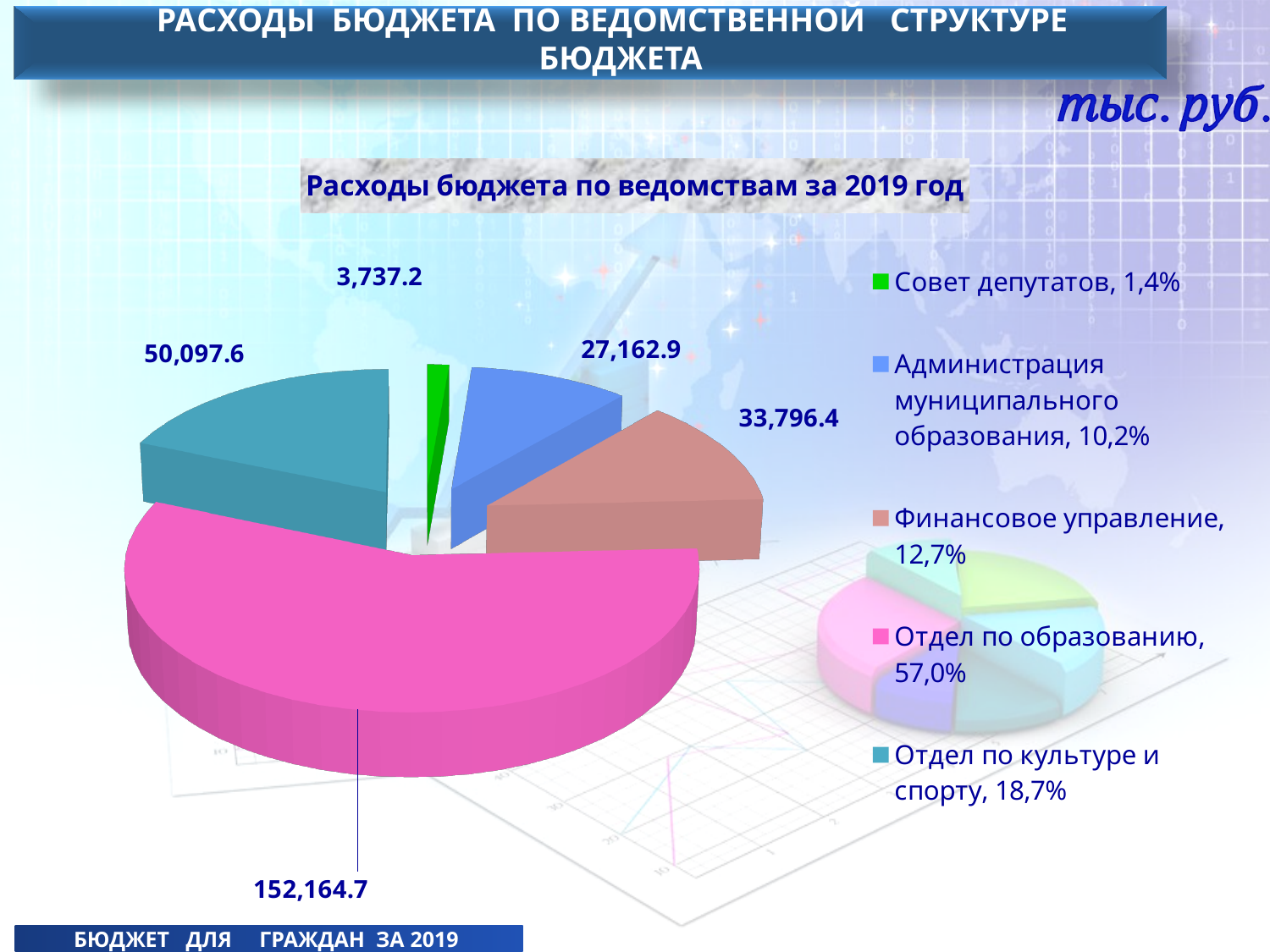
What is the value for Отдел по образованию? 152,164.7 How many slices does the pie chart have? 5 What is the value for Отдел по культуре и спорту? 50,097.6 Which is larger: the value for Отдел по культуре и спорту or the value for Финансовое управление? Отдел по культуре и спорту What type of chart is shown on the slide? pie chart Which category has the smallest slice of the pie? Совет депутатов What is the value for Финансовое управление? 33,796.4 What is the value for Совет депутатов? 3,737.2 What is the title of the chart? Расходы бюджета по ведомствам за 2019 год Which category has the largest slice of the pie? Отдел по образованию What is the difference between the values for Финансовое управление and Администрация муниципального образования? 6,633.5 What share of the pie does Отдел по культуре и спорту represent, as shown in the legend? 18,7%